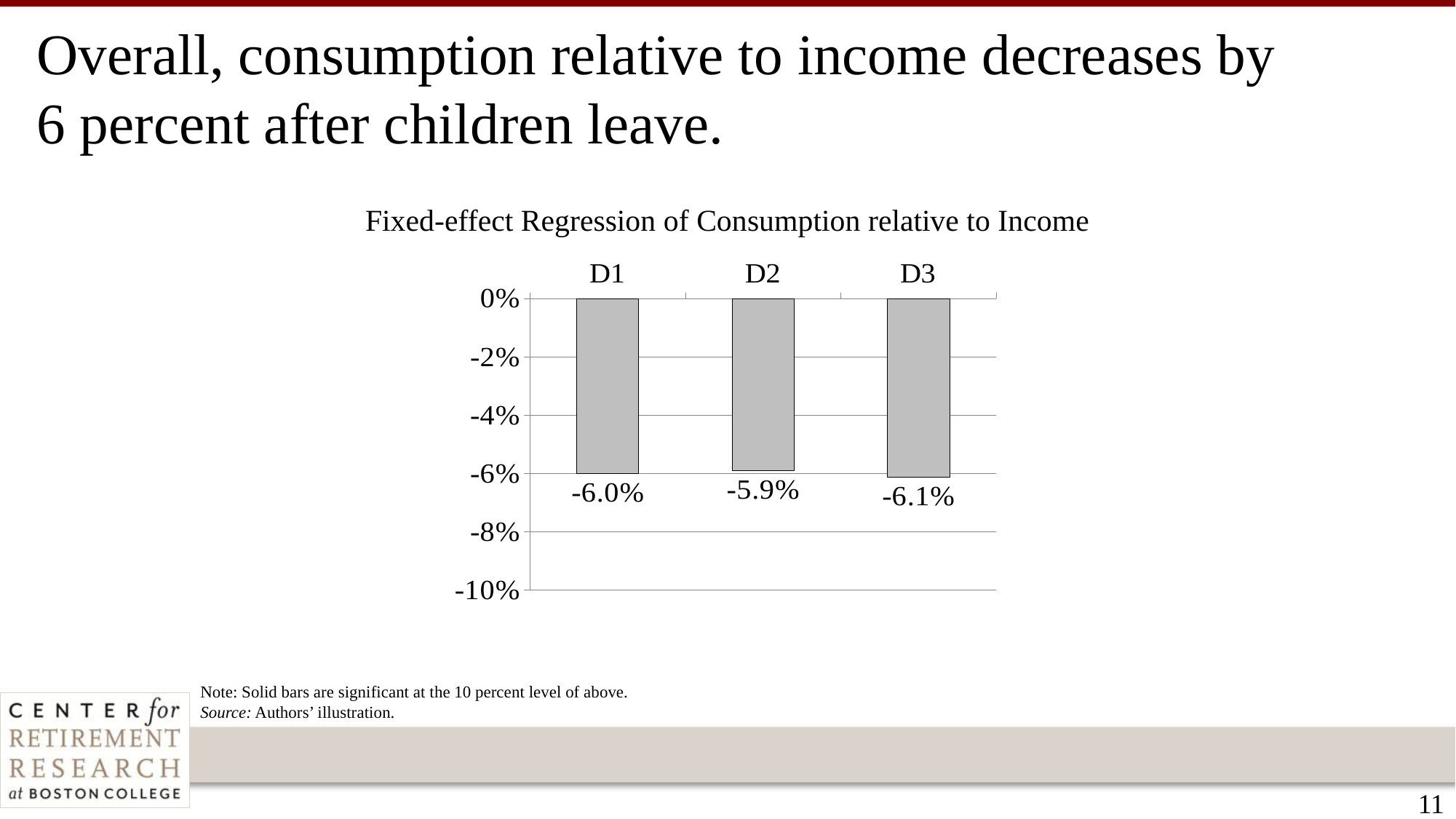
What is the value for D3? -6.1% Is the value for D1 greater or less than -4%? less What is the value for D2? -5.9% What is the difference between the values for D2 and D3? 0.2 percentage points What is the difference between the values for D3 and D1? 0.1 percentage points Which category has the highest (least negative) value? D2 Which category has the lowest (most negative) value? D3 What is the title of the chart? Fixed-effect Regression of Consumption relative to Income What kind of chart is shown on the slide? bar chart What is the value for D1? -6.0% Which is larger, the value for D2 or the value for D3? D2 How many categories are shown in the chart? 3